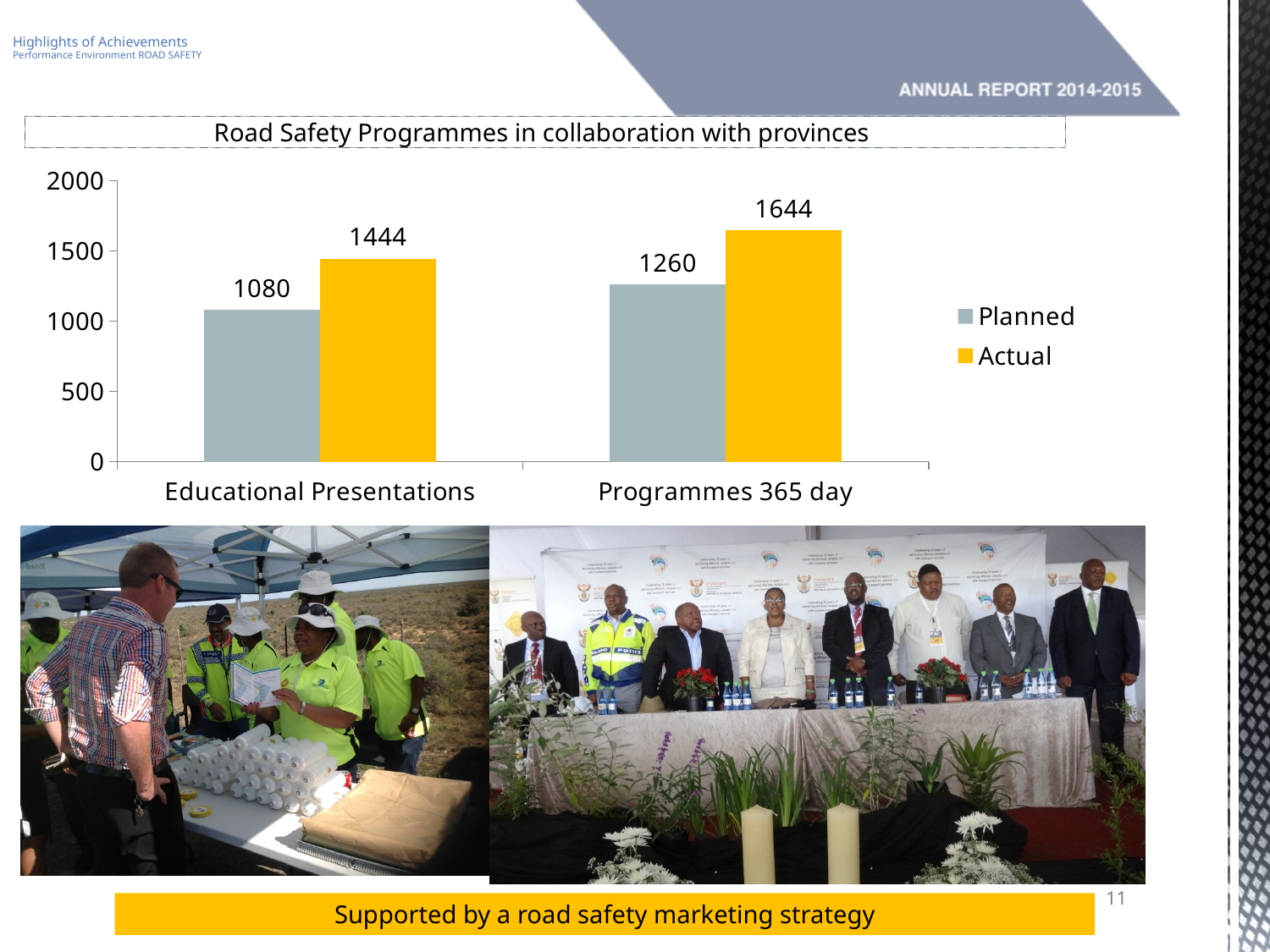
What is the difference between the Actual and Planned values for Programmes 365 day? 384 What kind of chart is shown on the slide? Bar chart What is the Actual value for Educational Presentations? 1444 Which category has the highest Actual value? Programmes 365 day What is the Actual value for Programmes 365 day? 1644 How many series does the legend list? 2 Which category has the lowest Planned value? Educational Presentations What is the difference between the Actual and Planned values for Educational Presentations? 364 Which is larger: the Planned value for Programmes 365 day or the Actual value for Educational Presentations? Actual value for Educational Presentations What is the Planned value for Educational Presentations? 1080 What is the title of the chart? Road Safety Programmes in collaboration with provinces What is the Planned value for Programmes 365 day? 1260